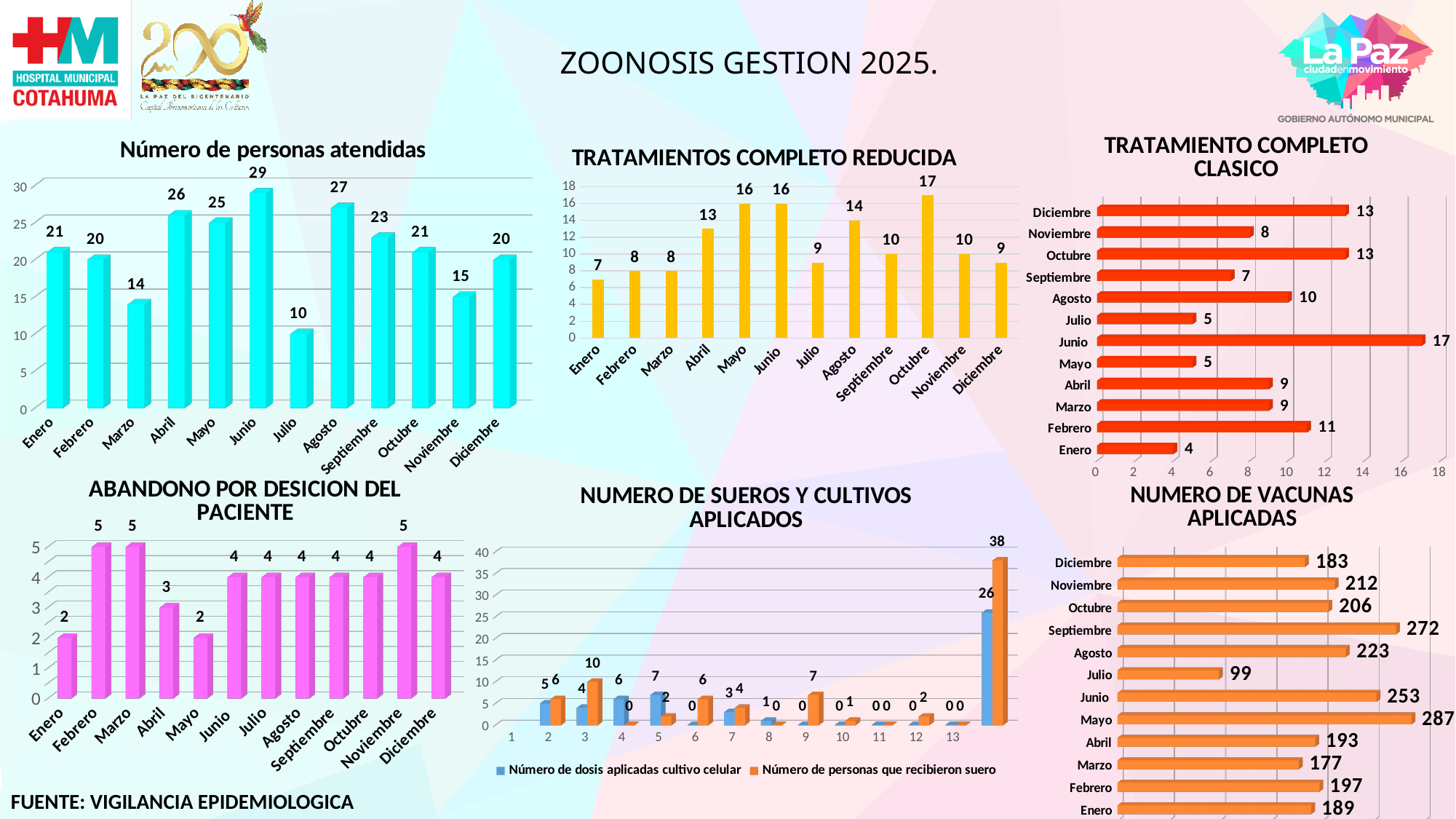
In the 'TRATAMIENTO COMPLETO CLASICO' chart, what is the difference between the values for Junio and Enero? 13 In the 'TRATAMIENTO COMPLETO CLASICO' chart, what is the value for Febrero? 11 In the 'TRATAMIENTOS COMPLETO REDUCIDA' chart, which month has the highest value? Octubre In the 'NUMERO DE SUEROS Y CULTIVOS APLICADOS' chart, what is the value of 'Número de personas que recibieron suero' for category 3? 10 In the 'ABANDONO POR DESICION DEL PACIENTE' chart, what is the value for Abril? 3 In the 'NUMERO DE VACUNAS APLICADAS' chart, is the value for Septiembre larger than the value for Agosto? Yes In the 'ABANDONO POR DESICION DEL PACIENTE' chart, how many months are shown on the x axis? 12 In the 'NUMERO DE SUEROS Y CULTIVOS APLICADOS' chart, how many series does the legend list? 2 In the 'Número de personas atendidas' chart, how many people were attended in Junio? 29 In the 'NUMERO DE VACUNAS APLICADAS' chart, which month has the highest value? Mayo In the 'TRATAMIENTOS COMPLETO REDUCIDA' chart, what is the value for Abril? 13 In the 'Número de personas atendidas' chart, which month has the lowest value? Julio